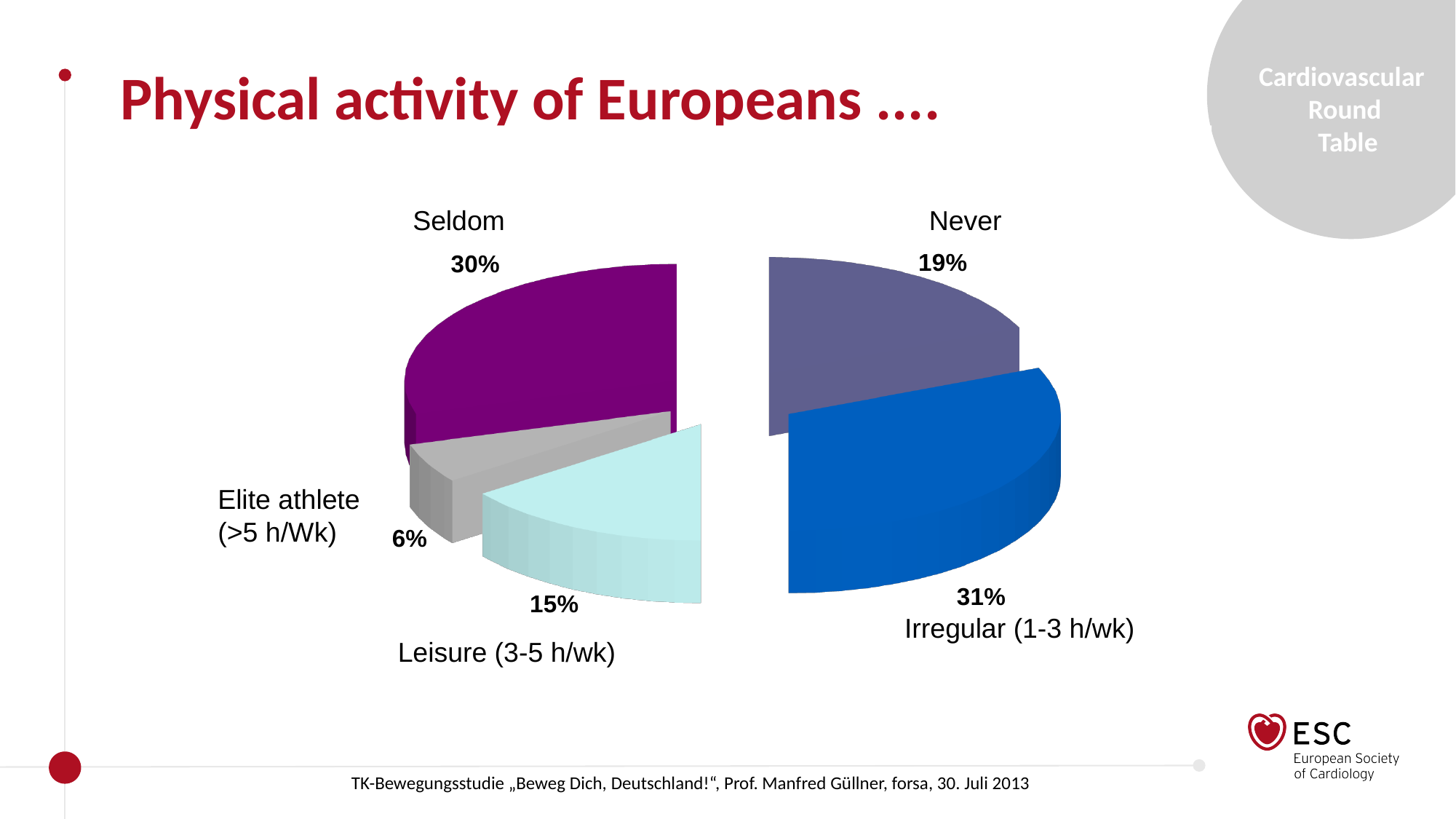
What percentage of Europeans are Elite athletes (>5 h/Wk)? 6% What percentage of Europeans are in the Leisure (3-5 h/wk) category? 15% What is the difference in percentage points between the Seldom and Never categories? 11 What percentage of Europeans are in the Irregular (1-3 h/wk) category? 31% What is the combined share of the Leisure (3-5 h/wk) and Elite athlete (>5 h/Wk) categories? 21% What percentage of Europeans are in the Seldom category? 30% What is the title of the slide containing the chart? Physical activity of Europeans .... Which category has the smallest share of the pie? Elite athlete (>5 h/Wk) What percentage of Europeans are in the Never category? 19% What kind of chart is shown on the slide? Pie chart Which is larger, the Leisure (3-5 h/wk) share or the Never share? Never How many categories does the pie chart show? 5